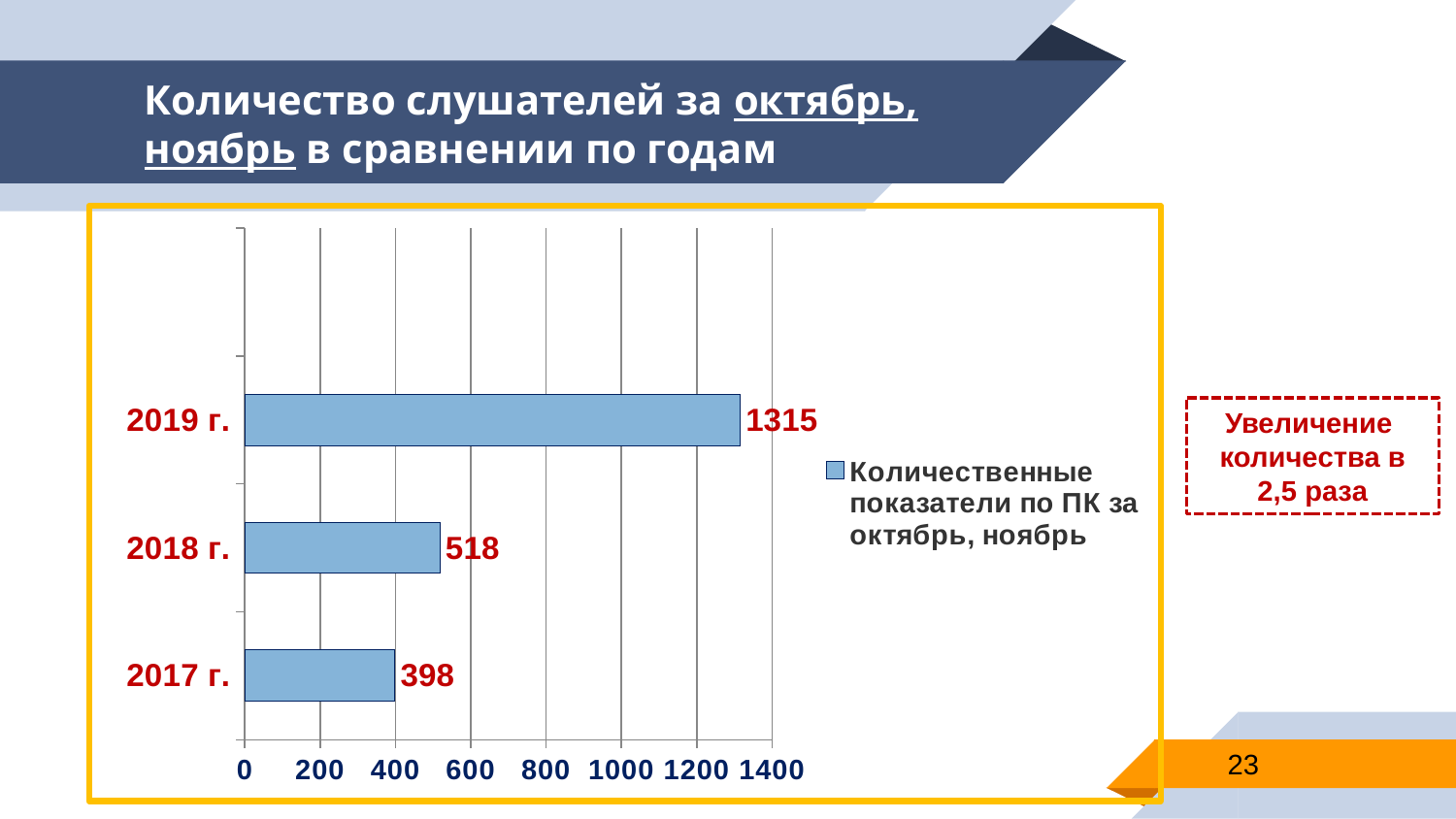
What is the value for 2017 г.? 398 What is the difference between the values for 2018 г. and 2017 г.? 120 What is the value for 2019 г.? 1315 How many years are shown on the chart? 3 What kind of chart is shown on the slide? bar chart Which year has the lowest value? 2017 г. Which year has the highest value? 2019 г. What is the value for 2018 г.? 518 Is the value for 2019 г. greater or less than 1200? greater How many series does the legend list? 1 Which is larger, the value for 2018 г. or the value for 2017 г.? 2018 г. What is the difference between the values for 2019 г. and 2018 г.? 797